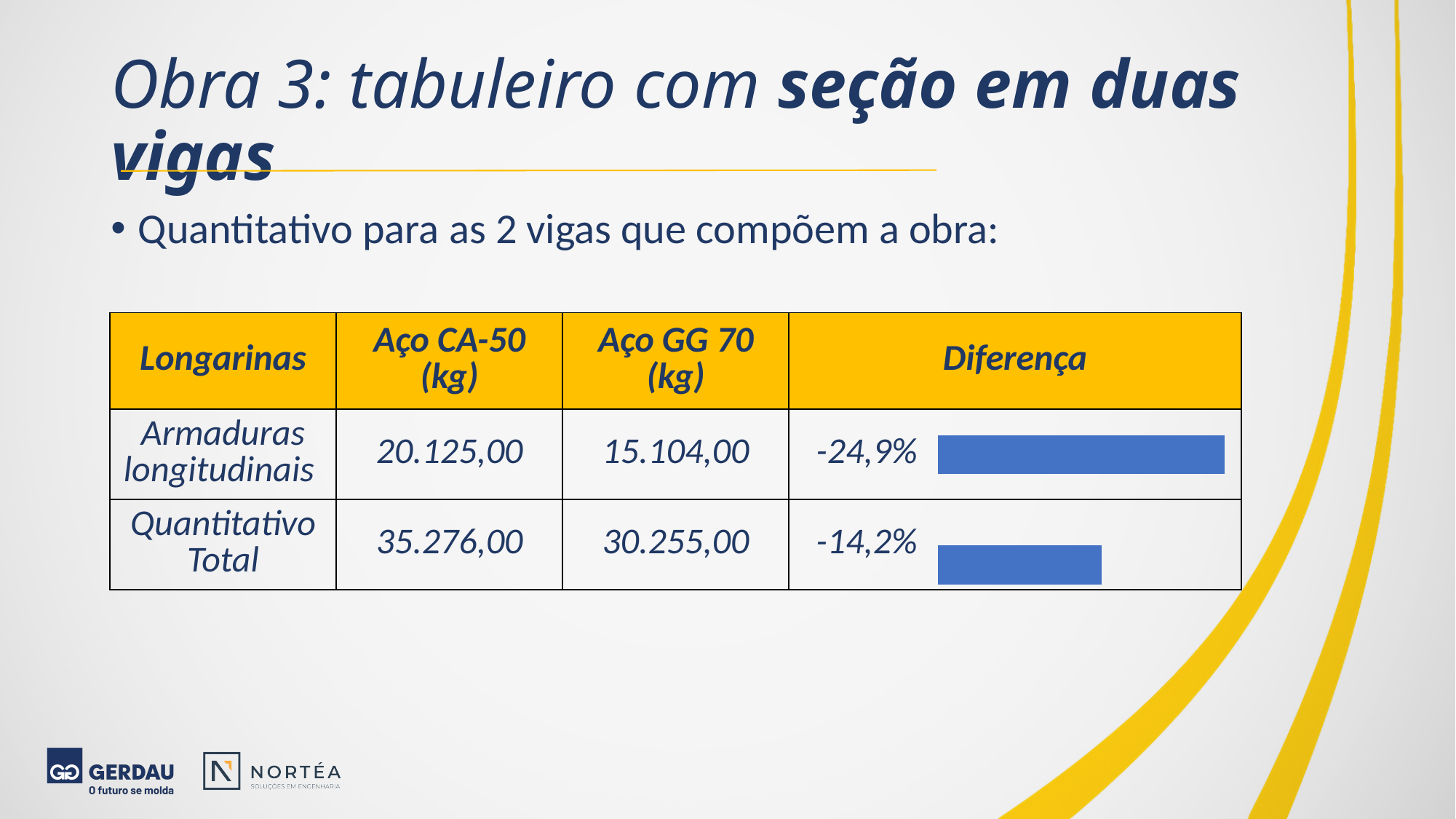
What colour are the bars in the Diferença column? blue How many bars are shown in the Diferença column? 2 What is the Diferença value shown next to the bar for Armaduras longitudinais? -24,9% What is the Aço GG 70 (kg) value for Quantitativo Total? 30.255,00 What kind of chart is shown in the Diferença column of the table? bar chart Which row shows the largest percentage reduction in the Diferença column? Armaduras longitudinais What is the Diferença value shown next to the bar for Quantitativo Total? -14,2% By how many percentage points does the Diferença for Armaduras longitudinais (-24,9%) exceed that for Quantitativo Total (-14,2%) in magnitude? 10,7 percentage points Which row shows the smallest percentage reduction in the Diferença column? Quantitativo Total Which row has the longer bar in the Diferença column, Armaduras longitudinais or Quantitativo Total? Armaduras longitudinais What is the Aço CA-50 (kg) value for Armaduras longitudinais? 20.125,00 What is the difference in kg between Aço CA-50 (35.276,00) and Aço GG 70 (30.255,00) for Quantitativo Total? 5.021,00